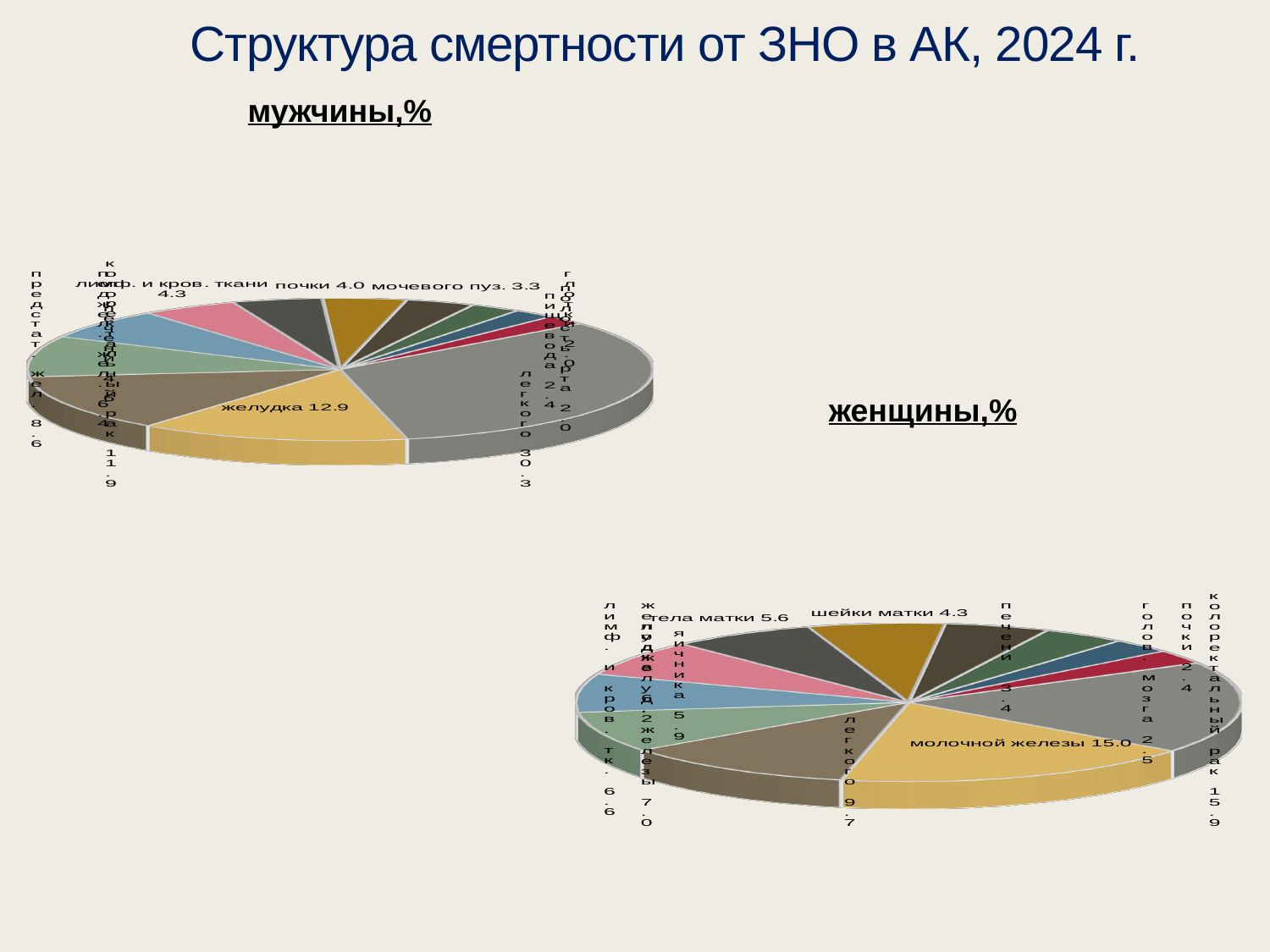
In the "мужчины,%" chart, which category has the largest share? легкого What kind of chart is used on the slide for the "мужчины,%" data? pie chart In the "женщины,%" chart, what is the value for молочной железы? 15.0 In the "мужчины,%" chart, what is the value for легкого? 30.3 In the "мужчины,%" chart, what is the value for желудка? 12.9 In the "женщины,%" chart, which is larger: молочной железы or легкого? молочной железы In the "мужчины,%" chart, what is the difference between the values for легкого and желудка? 17.4 In the "мужчины,%" chart, which is larger: лимф. и кров. ткани or мочевого пуз.? лимф. и кров. ткани In the "женщины,%" chart, what is the value for шейки матки? 4.3 In the "женщины,%" chart, what is the value for тела матки? 5.6 What is the title of the slide? Структура смертности от ЗНО в АК, 2024 г. In the "мужчины,%" chart, what is the value for почки? 4.0